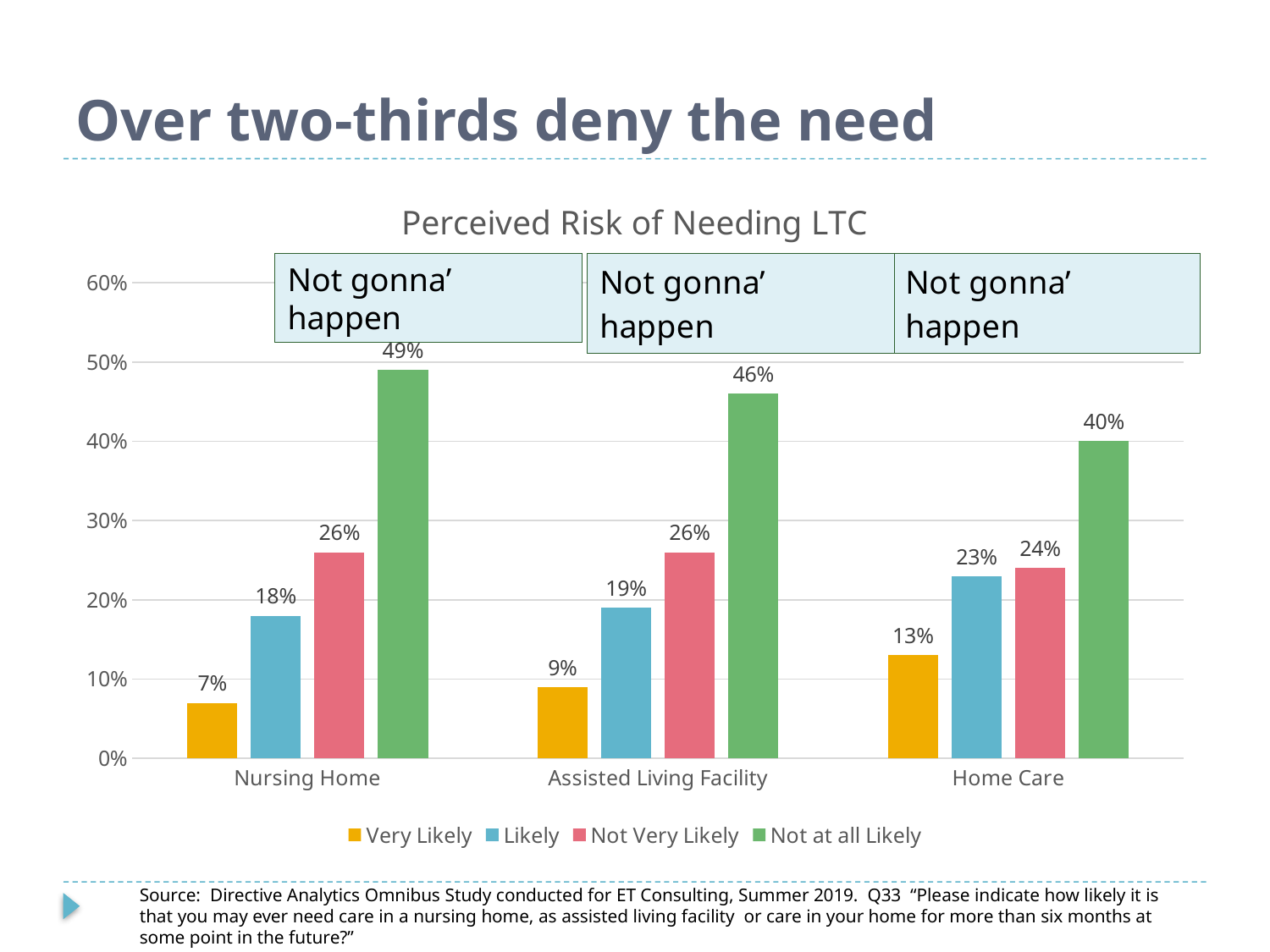
Do the Not at all Likely values rise or fall from Nursing Home to Home Care? Fall Which is larger, the Likely value for Home Care or the Likely value for Nursing Home? Home Care What is the title of the chart? Perceived Risk of Needing LTC What is the value for Likely for Assisted Living Facility? 19% How many categories are shown on the x axis? 3 Which category has the lowest Very Likely value? Nursing Home What is the difference between the Not at all Likely values for Nursing Home and Home Care? 9% Which category has the highest Not at all Likely value? Nursing Home What is the value for Not at all Likely for Nursing Home? 49% How many series does the legend list? 4 What kind of chart is shown on the slide? Bar chart What is the value for Very Likely for Home Care? 13%